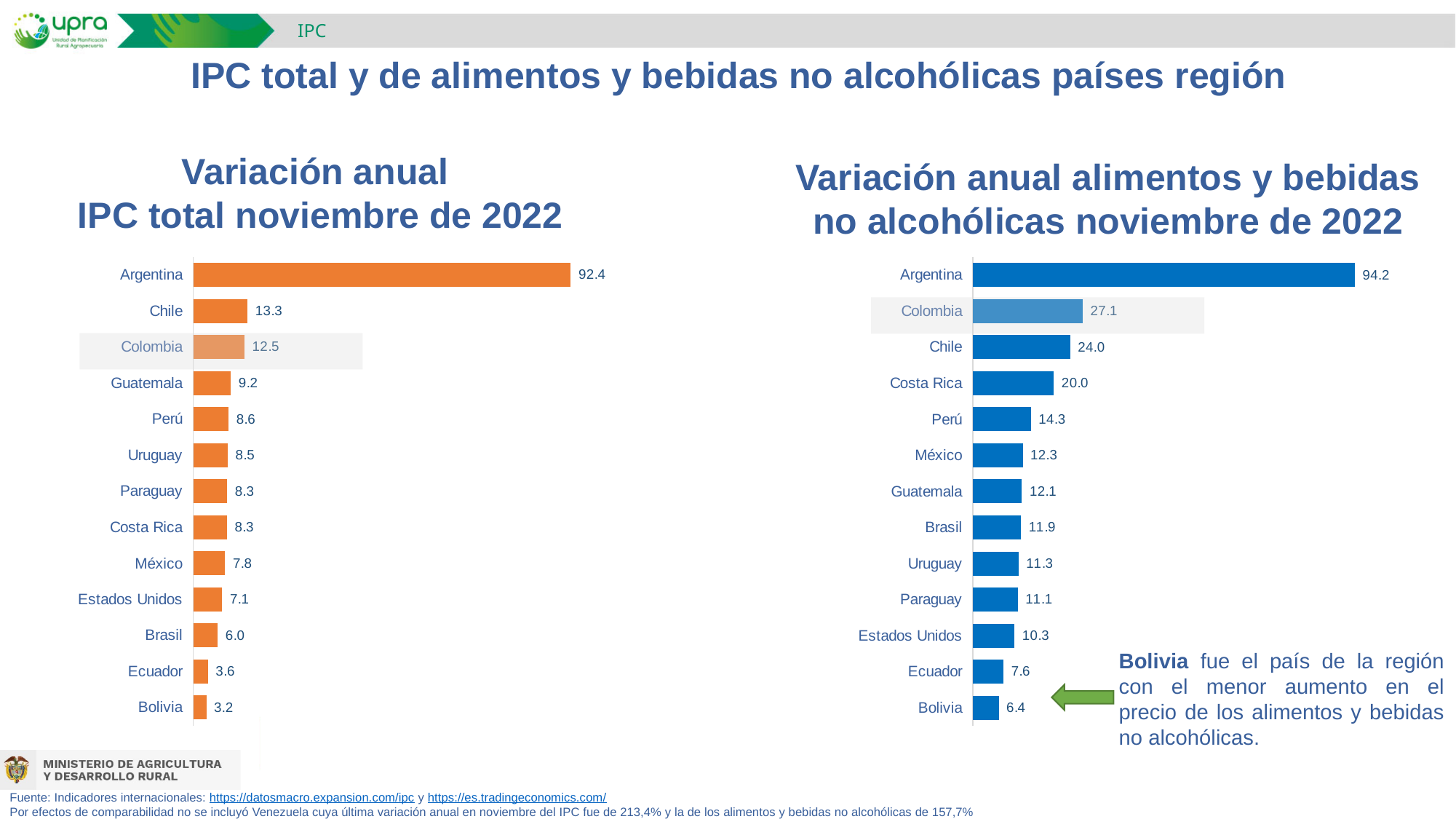
In the 'Variación anual alimentos y bebidas no alcohólicas noviembre de 2022' chart, which country has the lowest value? Bolivia Which country is highlighted with a shaded row in both charts? Colombia In the 'Variación anual alimentos y bebidas no alcohólicas noviembre de 2022' chart, what is the value for Estados Unidos? 10.3 What type of chart is the 'Variación anual IPC total noviembre de 2022' chart? Bar chart In the 'Variación anual alimentos y bebidas no alcohólicas noviembre de 2022' chart, which is larger, the value for Colombia or the value for Chile? Colombia In the 'Variación anual IPC total noviembre de 2022' chart, how many countries are shown? 13 In the 'Variación anual IPC total noviembre de 2022' chart, what is the value for Colombia? 12.5 In the 'Variación anual alimentos y bebidas no alcohólicas noviembre de 2022' chart, what is the difference between the values for Argentina and Colombia? 67.1 In the 'Variación anual alimentos y bebidas no alcohólicas noviembre de 2022' chart, what is the value for Costa Rica? 20.0 In the 'Variación anual IPC total noviembre de 2022' chart, which country has the highest value? Argentina In the 'Variación anual IPC total noviembre de 2022' chart, which country has the lowest value? Bolivia In the 'Variación anual IPC total noviembre de 2022' chart, what is the difference between the values for Chile and Colombia? 0.8